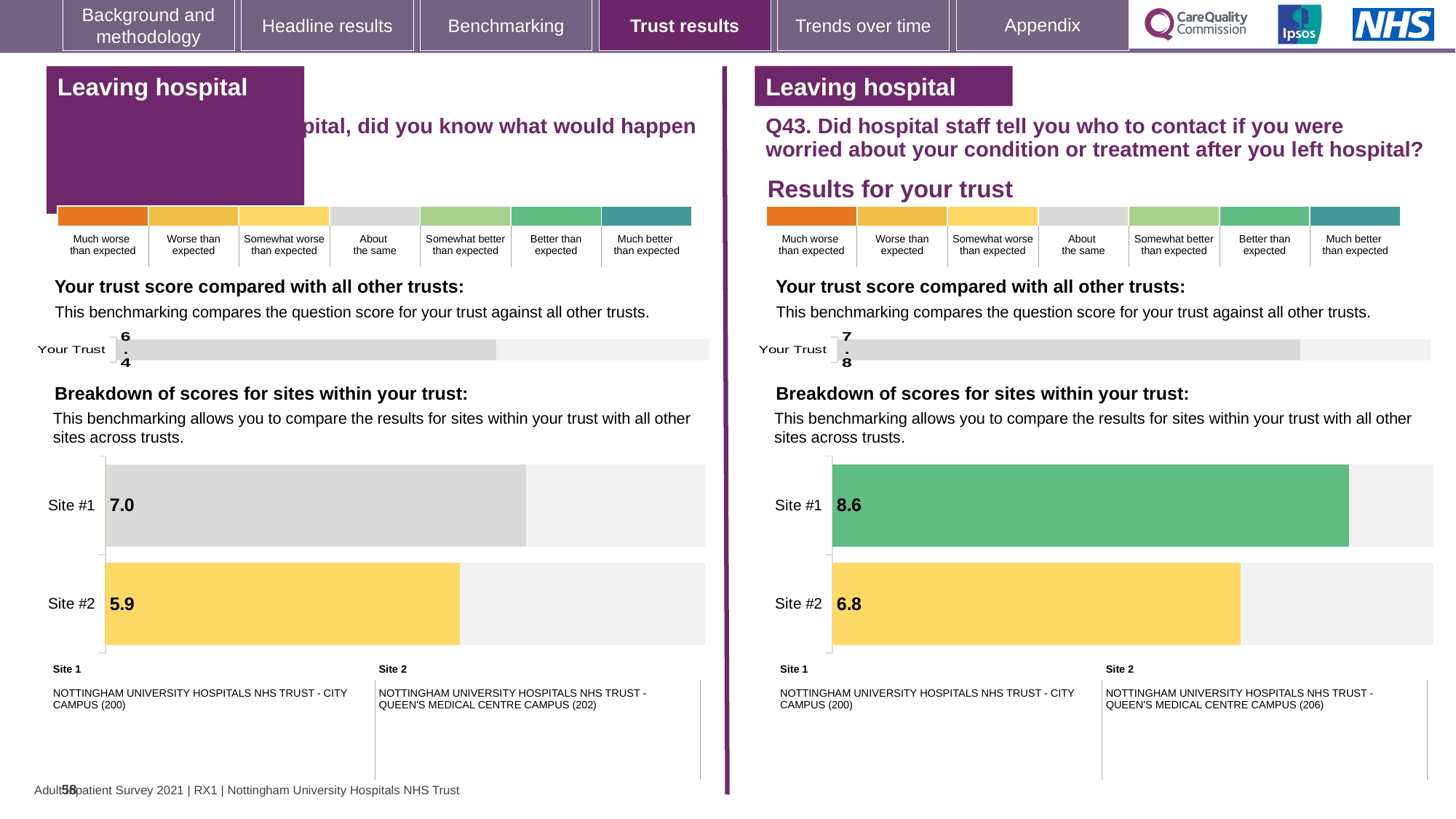
In the site breakdown chart on the left-hand side of the slide, what is the difference between the Site #1 and Site #2 scores? 1.1 In the Q43 site breakdown chart on the right, which site has the higher score? Site #1 In the site breakdown chart on the left-hand side of the slide, what is the score for Site #2? 5.9 What type of chart is used for the site breakdown on the right-hand side of the slide? Bar chart In the Q43 site breakdown chart on the right, what is the difference between the Site #1 and Site #2 scores? 1.8 In the Q43 'Your trust score compared with all other trusts' chart on the right, what is the score shown for Your Trust? 7.8 In the 'Your trust score compared with all other trusts' chart on the left-hand side of the slide, what is the score shown for Your Trust? 6.4 In the site breakdown chart on the left-hand side of the slide, which site has the lower score? Site #2 In the Q43 site breakdown chart on the right, what is the score for Site #1? 8.6 In the site breakdown chart on the left-hand side of the slide, what is the score for Site #1? 7.0 How many sites are shown in the Q43 site breakdown chart on the right? 2 In the Q43 site breakdown chart on the right, what is the score for Site #2? 6.8